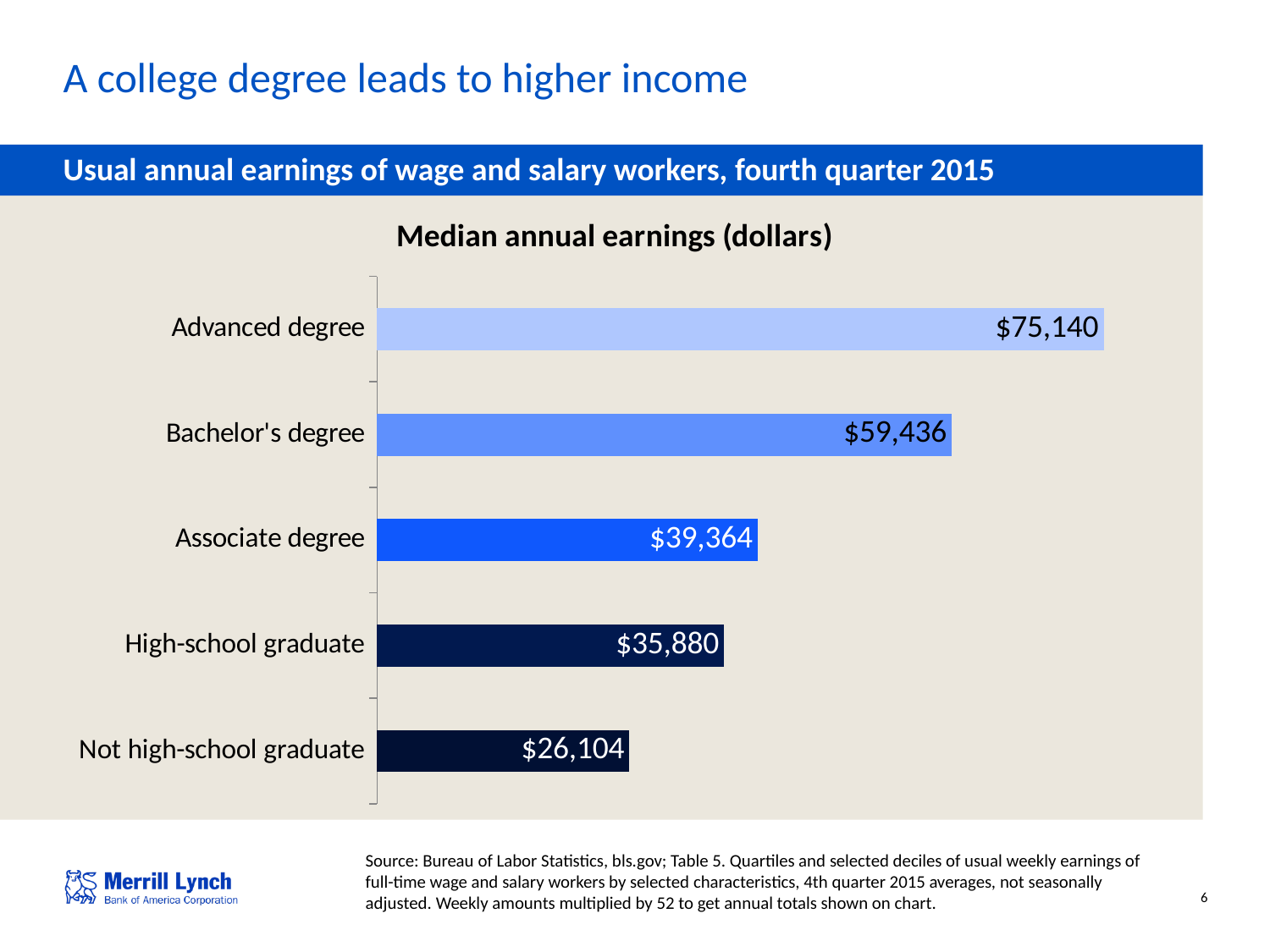
Which has higher median annual earnings: Associate degree or High-school graduate? Associate degree Which education level has the lowest median annual earnings? Not high-school graduate How many education levels are shown in the chart? 5 What is the median annual earnings for workers with an Advanced degree? $75,140 What is the median annual earnings for workers who are Not high-school graduates? $26,104 What is the median annual earnings for workers with an Associate degree? $39,364 What is the difference in median annual earnings between an Advanced degree and a Bachelor's degree? $15,704 Which education level has the highest median annual earnings? Advanced degree What is the median annual earnings for High-school graduates? $35,880 What type of chart is shown on the slide? Bar chart What is the median annual earnings for workers with a Bachelor's degree? $59,436 What is the difference in median annual earnings between a High-school graduate and a Not high-school graduate? $9,776